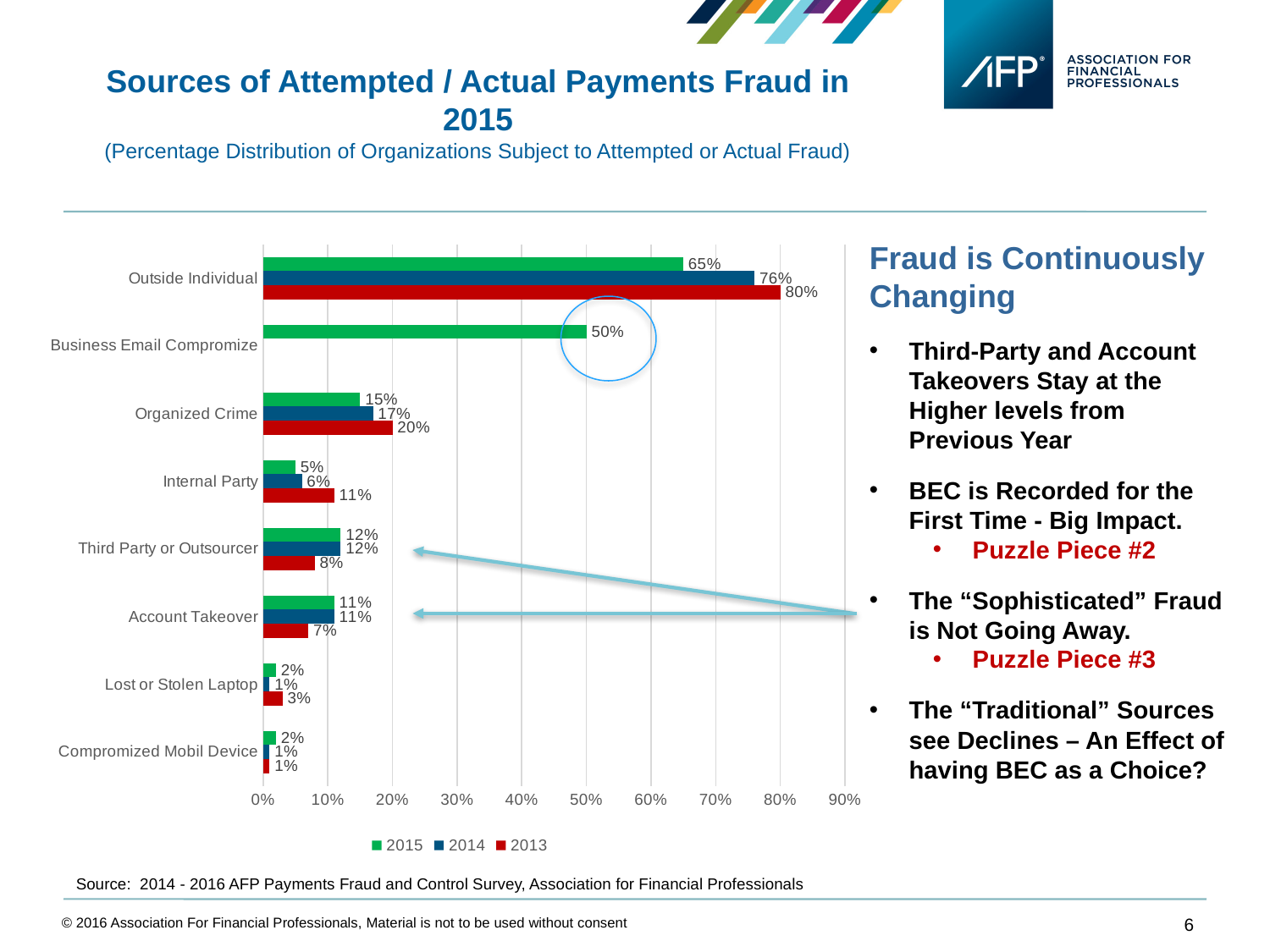
What is the 2015 value for Business Email Compromize? 50% What is the difference between the 2013 and 2015 values for Outside Individual? 15% What is the 2015 value for Outside Individual? 65% How many categories are shown on the chart? 8 Which series is shown in red in the legend? 2013 How many series does the legend list? 3 Which category has the lowest 2013 value? Compromized Mobil Device What kind of chart is shown on the slide? Bar chart Which is larger for Third Party or Outsourcer: the 2015 value or the 2013 value? 2015 Which category has the highest 2014 value? Outside Individual What is the 2013 value for Organized Crime? 20% What is the 2014 value for Internal Party? 6%